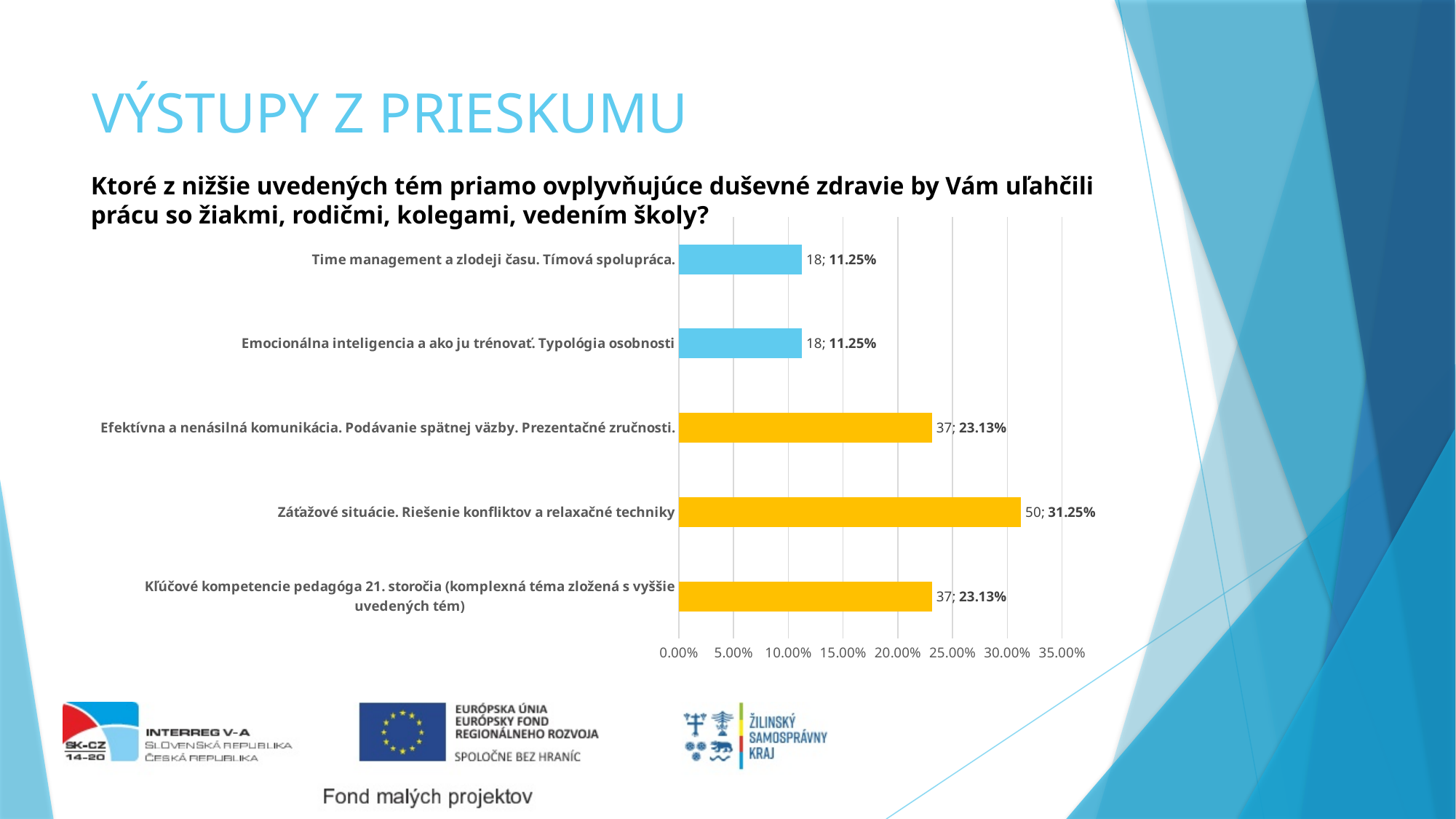
How many bars in the chart are coloured yellow? 3 Is the value for "Záťažové situácie. Riešenie konfliktov a relaxačné techniky" greater or less than 30.00%? greater What percentage is shown for "Záťažové situácie. Riešenie konfliktov a relaxačné techniky"? 31.25% What is the difference in percentage between "Záťažové situácie. Riešenie konfliktov a relaxačné techniky" and "Time management a zlodeji času. Tímová spolupráca."? 20.00% What kind of chart is shown on the slide? bar chart How many respondents chose "Emocionálna inteligencia a ako ju trénovať. Typológia osobnosti"? 18 What is the difference in respondent count between "Záťažové situácie. Riešenie konfliktov a relaxačné techniky" and "Kľúčové kompetencie pedagóga 21. storočia"? 13 How many respondents chose "Efektívna a nenásilná komunikácia. Podávanie spätnej väzby. Prezentačné zručnosti."? 37 What percentage is shown for "Time management a zlodeji času. Tímová spolupráca."? 11.25% Which topic has the highest value in the chart? Záťažové situácie. Riešenie konfliktov a relaxačné techniky Which has a larger value: "Efektívna a nenásilná komunikácia" or "Emocionálna inteligencia a ako ju trénovať"? Efektívna a nenásilná komunikácia How many topics (categories) are shown in the chart? 5